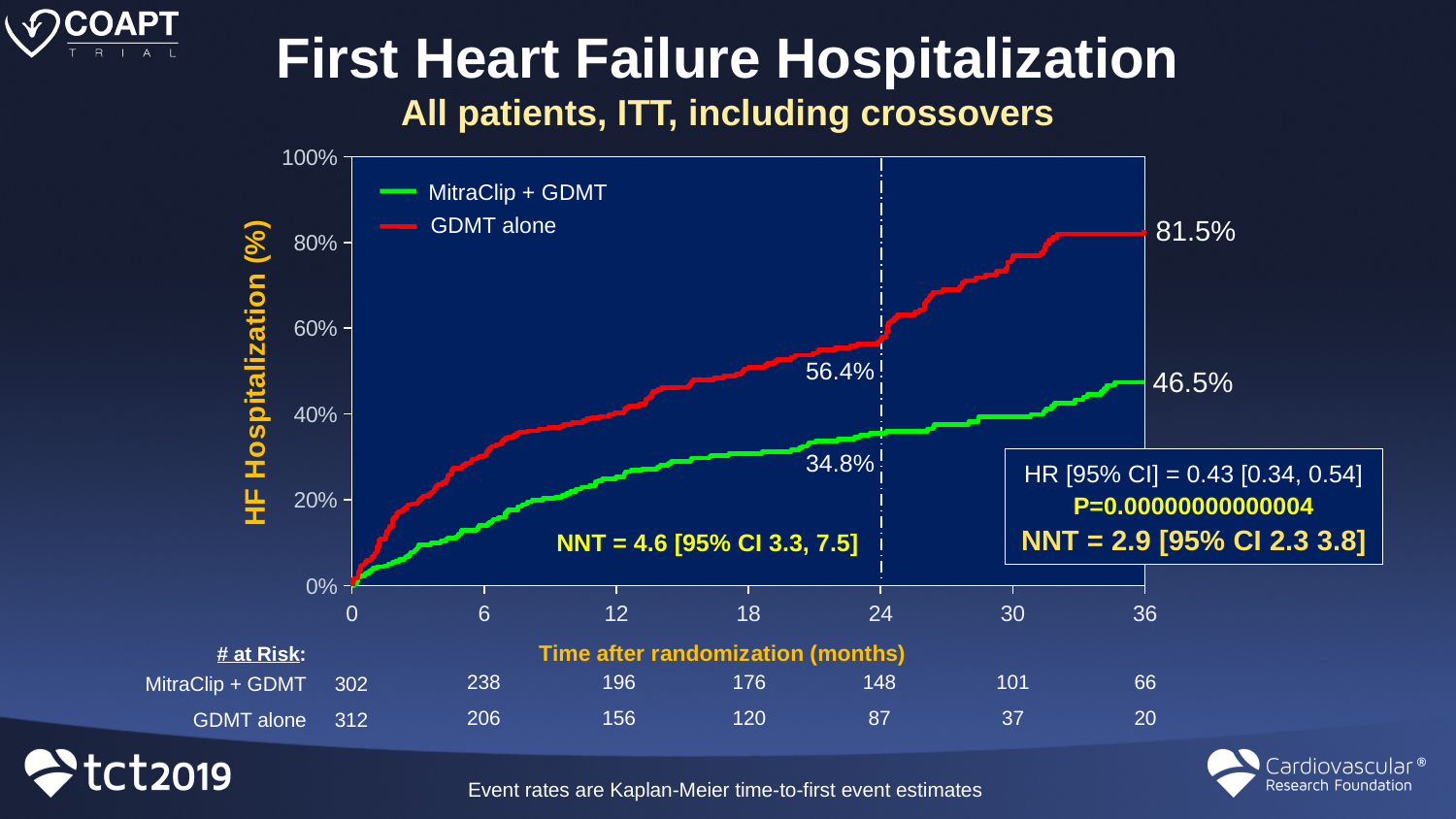
Which group has the higher HF hospitalization rate at 36 months, MitraClip + GDMT or GDMT alone? GDMT alone Do the HF hospitalization curves rise or fall as time after randomization increases? Rise What kind of chart is shown on the slide? Line chart (Kaplan-Meier curve) What is the HF hospitalization rate for GDMT alone at 36 months? 81.5% What is the difference in HF hospitalization rate between GDMT alone and MitraClip + GDMT at 36 months? 35.0 percentage points What is the HF hospitalization rate for MitraClip + GDMT at 24 months? 34.8% What is the hazard ratio with 95% CI shown on the chart? 0.43 [0.34, 0.54] What is the difference in HF hospitalization rate between GDMT alone and MitraClip + GDMT at 24 months? 21.6 percentage points What is the HF hospitalization rate for GDMT alone at 24 months? 56.4% What is the HF hospitalization rate for MitraClip + GDMT at 36 months? 46.5% How many series does the legend list? 2 How many MitraClip + GDMT patients are at risk at 24 months? 148